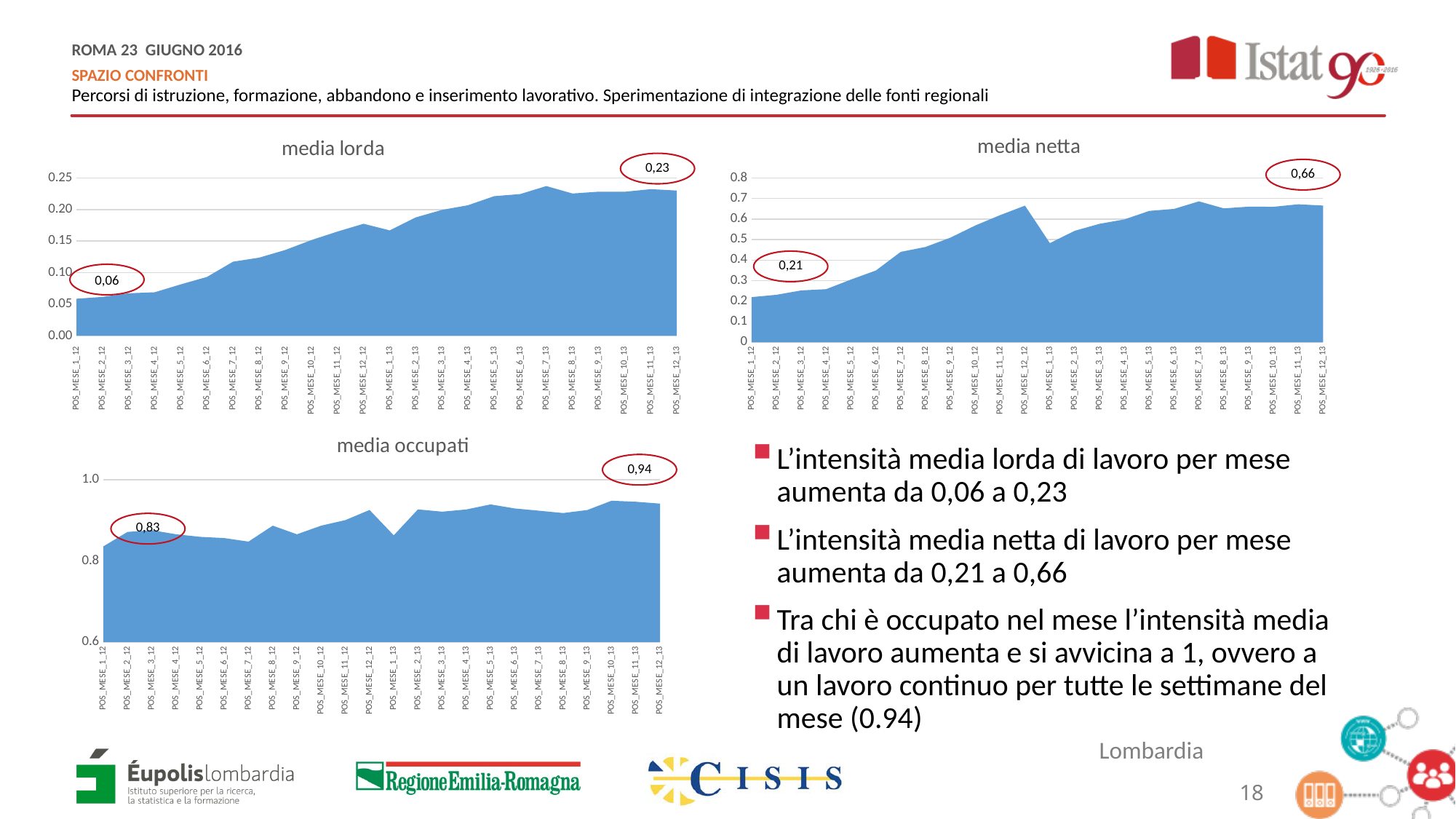
In the "media netta" chart, what is the difference between the value for POS_MESE_12_13 and the value for POS_MESE_1_12? 0,45 How many months (categories) are plotted on the x axis of the "media lorda" chart? 24 In the "media netta" chart, what is the value for POS_MESE_1_12? 0,21 In the "media netta" chart, is the value for POS_MESE_12_12 greater or less than 0.6? greater What kind of chart is the "media lorda" chart? area chart In the "media netta" chart, which is larger: the value for POS_MESE_12_12 or the value for POS_MESE_1_13? POS_MESE_12_12 In the "media netta" chart, what is the value for POS_MESE_12_13? 0,66 In the "media lorda" chart, what is the value for POS_MESE_12_13? 0,23 In the "media lorda" chart, what is the value for POS_MESE_1_12? 0,06 In the "media lorda" chart, do the values generally rise or fall from POS_MESE_1_12 to POS_MESE_12_13? rise In the "media lorda" chart, what is the difference between the value for POS_MESE_12_13 and the value for POS_MESE_1_12? 0,17 In the "media occupati" chart, what is the value for POS_MESE_12_13? 0,94